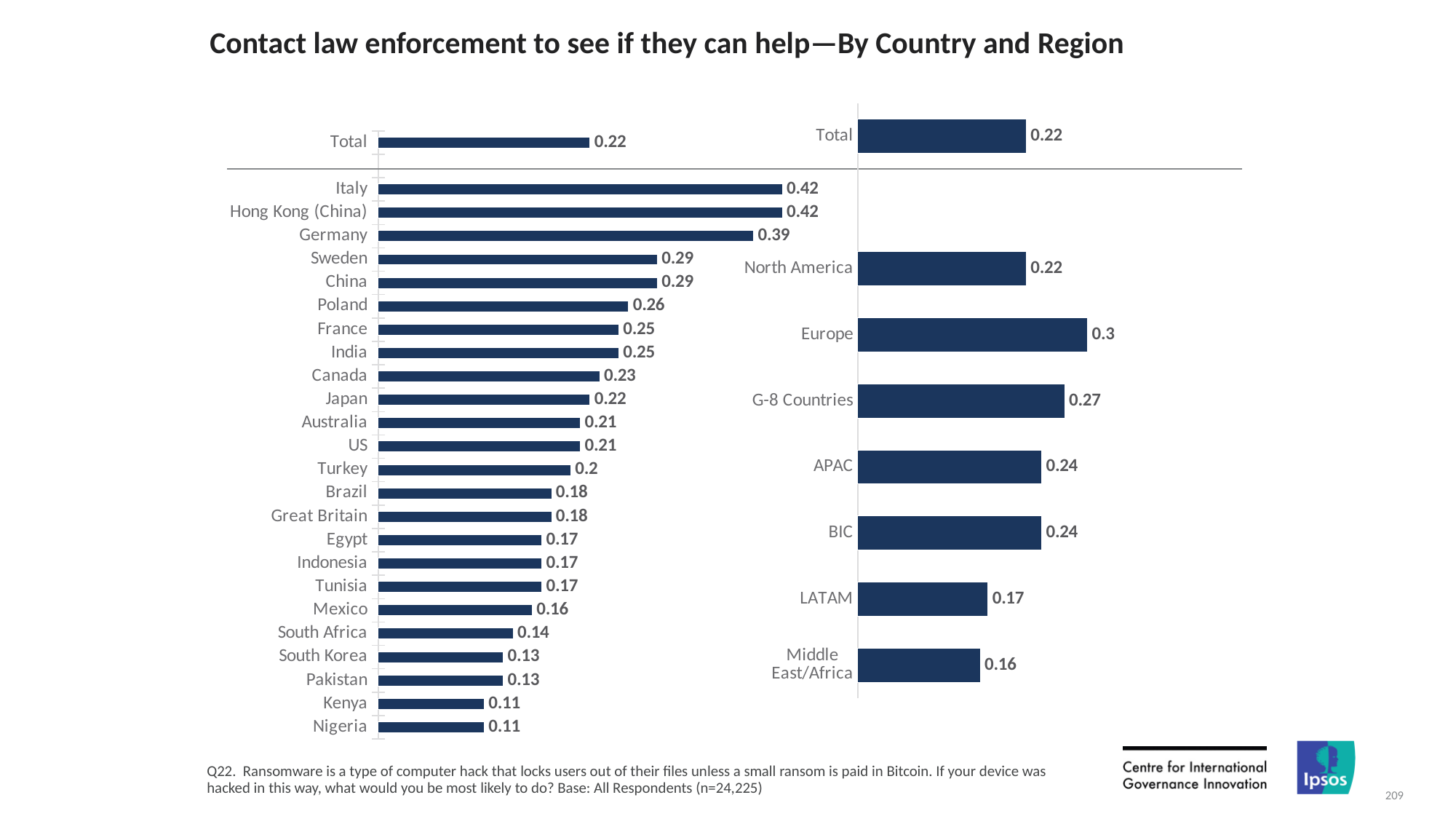
In the right chart (by region), which region has the highest value? Europe In the left chart (by country), what is the value for Canada? 0.23 In the left chart (by country), which is larger, the value for Sweden or the value for Turkey? Sweden In the left chart (by country), what is the difference between the values for Italy and Nigeria? 0.31 In the right chart (by region), what is the value for Europe? 0.3 How many countries (excluding Total) are listed in the left chart? 24 In the left chart (by country), what is the value for Germany? 0.39 What type of chart is used on this slide? Bar chart In the right chart (by region), what is the difference between the values for G-8 Countries and Middle East/Africa? 0.11 In the right chart (by region), which is larger, the value for APAC or the value for North America? APAC In the right chart (by region), what is the value for LATAM? 0.17 How many regions (excluding Total) are listed in the right chart? 7